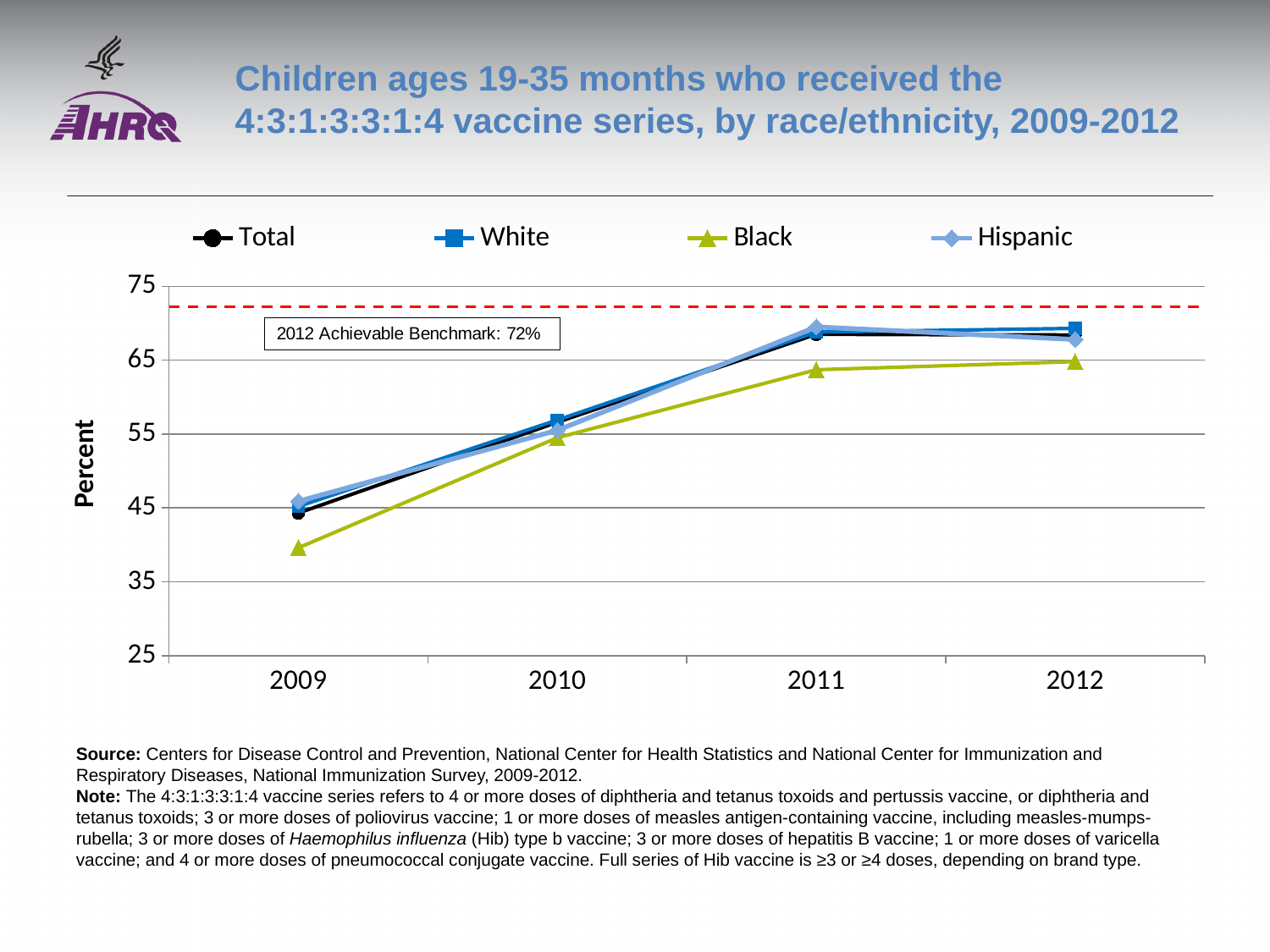
What is the 2012 Achievable Benchmark shown on the chart? 72% Is the value for White in 2010 greater or less than 55? greater In 2011, which is larger, the value for White or the value for Black? White Is the value for White in 2012 greater or less than 65? greater Is the value for Black in 2011 greater or less than 65? less Does the value for Black rise or fall from 2009 to 2012? rise How many series does the legend list? 4 What kind of chart is shown on the slide? line chart Which group has the lowest value in 2012? Black How many years are plotted along the x axis? 4 Which race/ethnicity group has the lowest value in 2009? Black